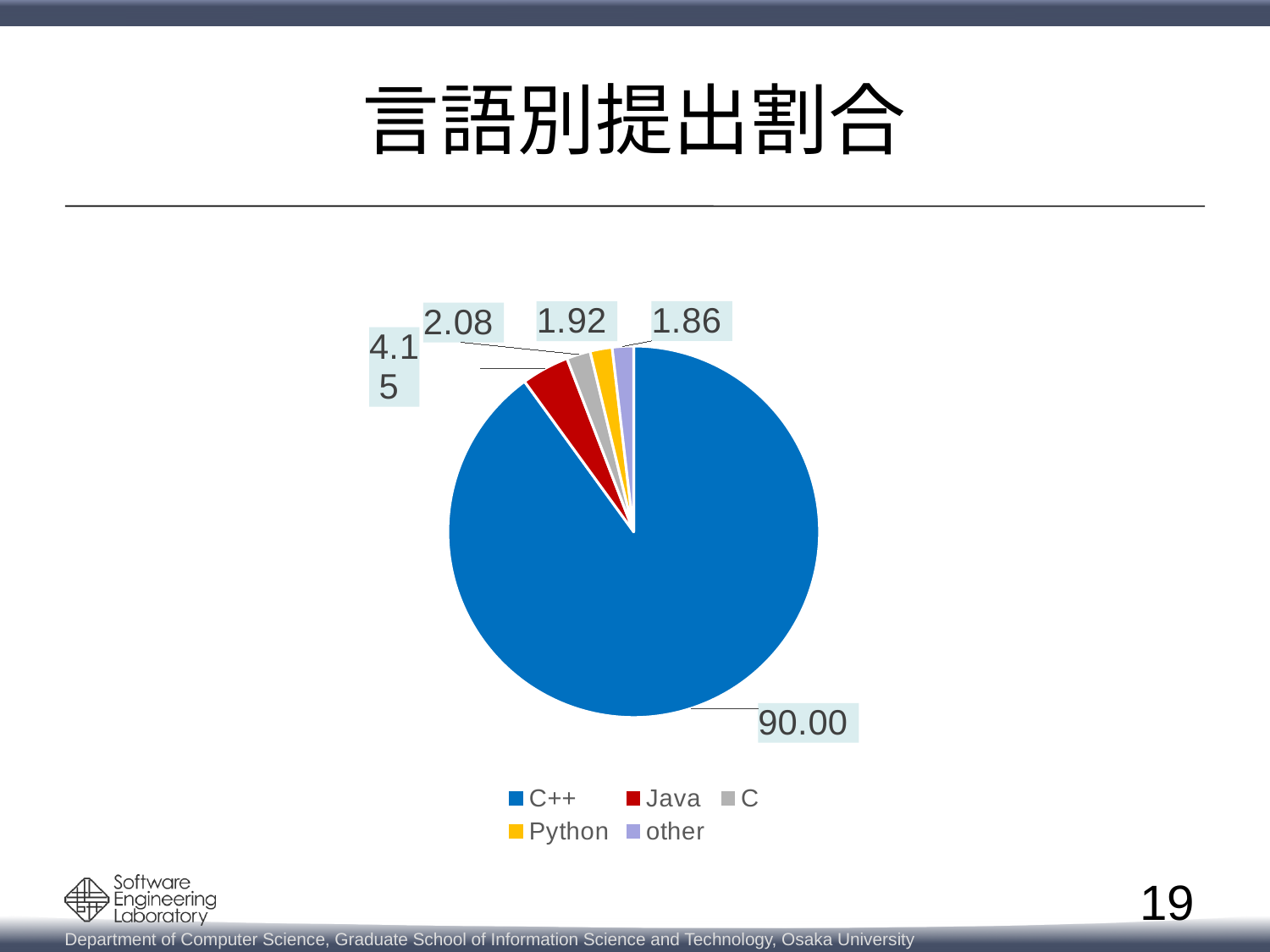
What is the value shown for the 'other' slice in the pie chart? 1.86 What is the title of the slide containing the pie chart? 言語別提出割合 Which category has the smallest slice of the pie chart? other Which language has the largest slice of the pie chart? C++ What is the value shown for Java in the pie chart? 4.15 What is the value shown for Python in the pie chart? 1.92 What is the value shown for C++ in the pie chart? 90.00 What is the value shown for C in the pie chart? 2.08 What is the difference between the values for C++ and Java? 85.85 What kind of chart is shown on the slide? pie chart Which is larger, the slice for Java or the slice for C? Java How many categories does the legend of the pie chart list? 5